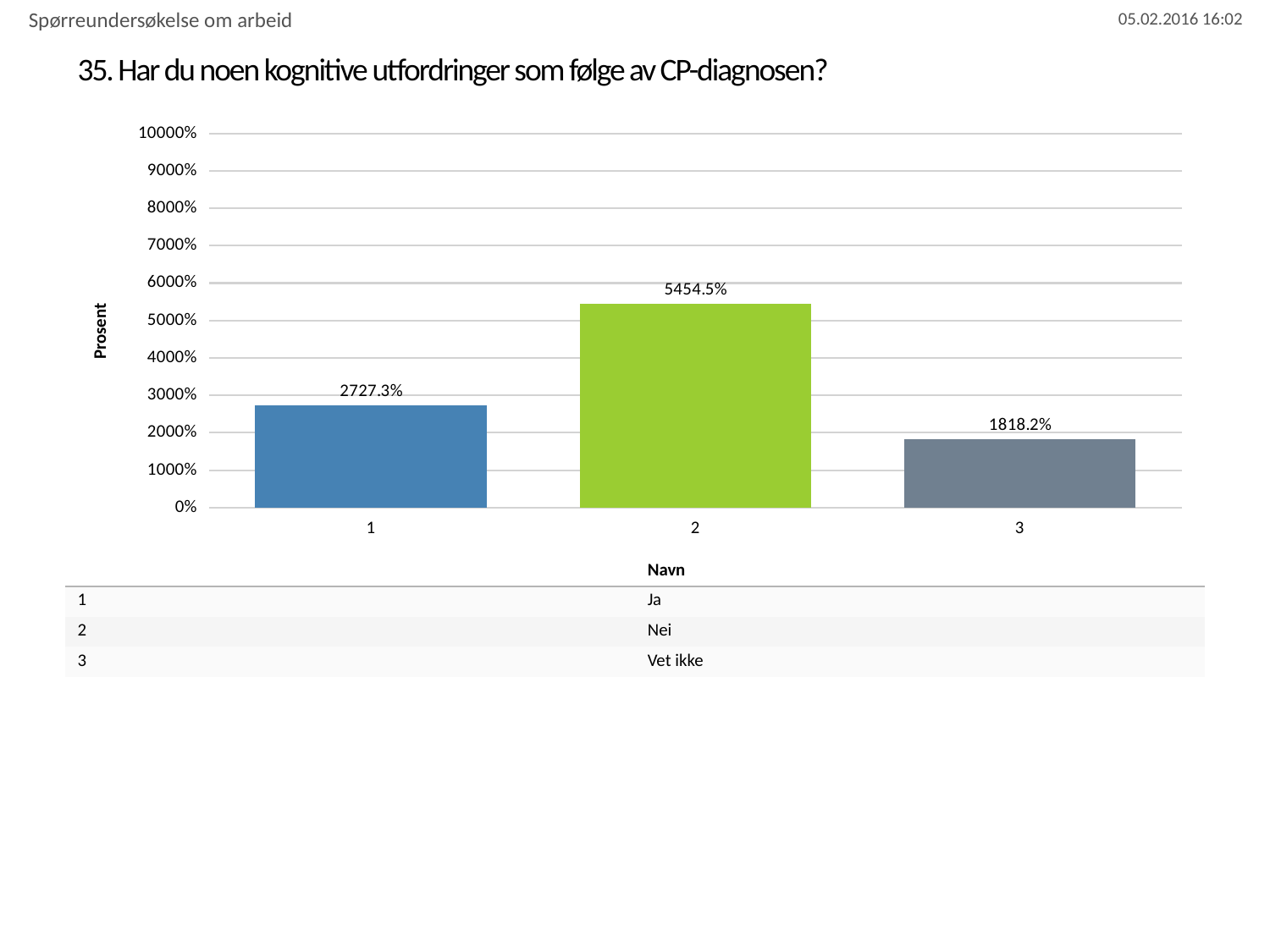
What is the difference between the values for category 2 and category 1? 2727.2% Is the value for category 2 greater or less than 5000%? greater What kind of chart is shown on the slide? bar chart What is the value for category 3 (Vet ikke)? 1818.2% What is the difference between the values for category 1 and category 3? 909.1% What is the label of the y axis? Prosent Which is larger, the value for category 1 or category 3? category 1 What is the value for category 1 (Ja)? 2727.3% Which category has the highest value? 2 What is the value for category 2 (Nei)? 5454.5% Which category has the lowest value? 3 How many bars are shown in the chart? 3